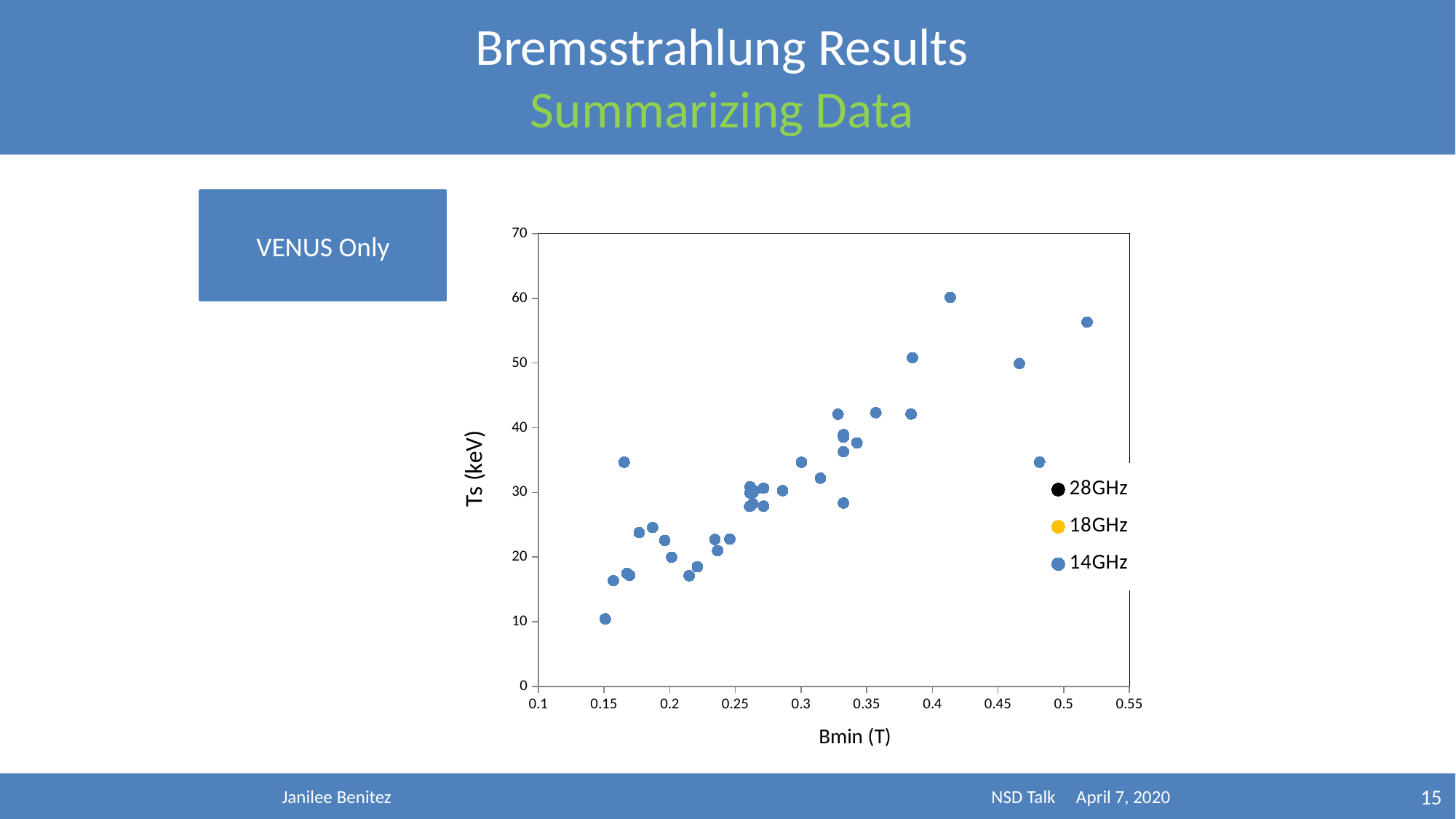
What kind of chart is shown on the slide? scatter plot How many series does the chart's legend list? 3 Is the Bmin value of the leftmost plotted point greater or less than 0.2 T? less What is the label of the chart's y axis? Ts (keV) Is the lowest Ts value plotted greater or less than 20 keV? less Is the highest Ts value plotted greater or less than 70 keV? less Which legend series do the plotted blue points belong to? 14GHz Do the Ts values generally rise or fall as Bmin increases along the x axis? rise